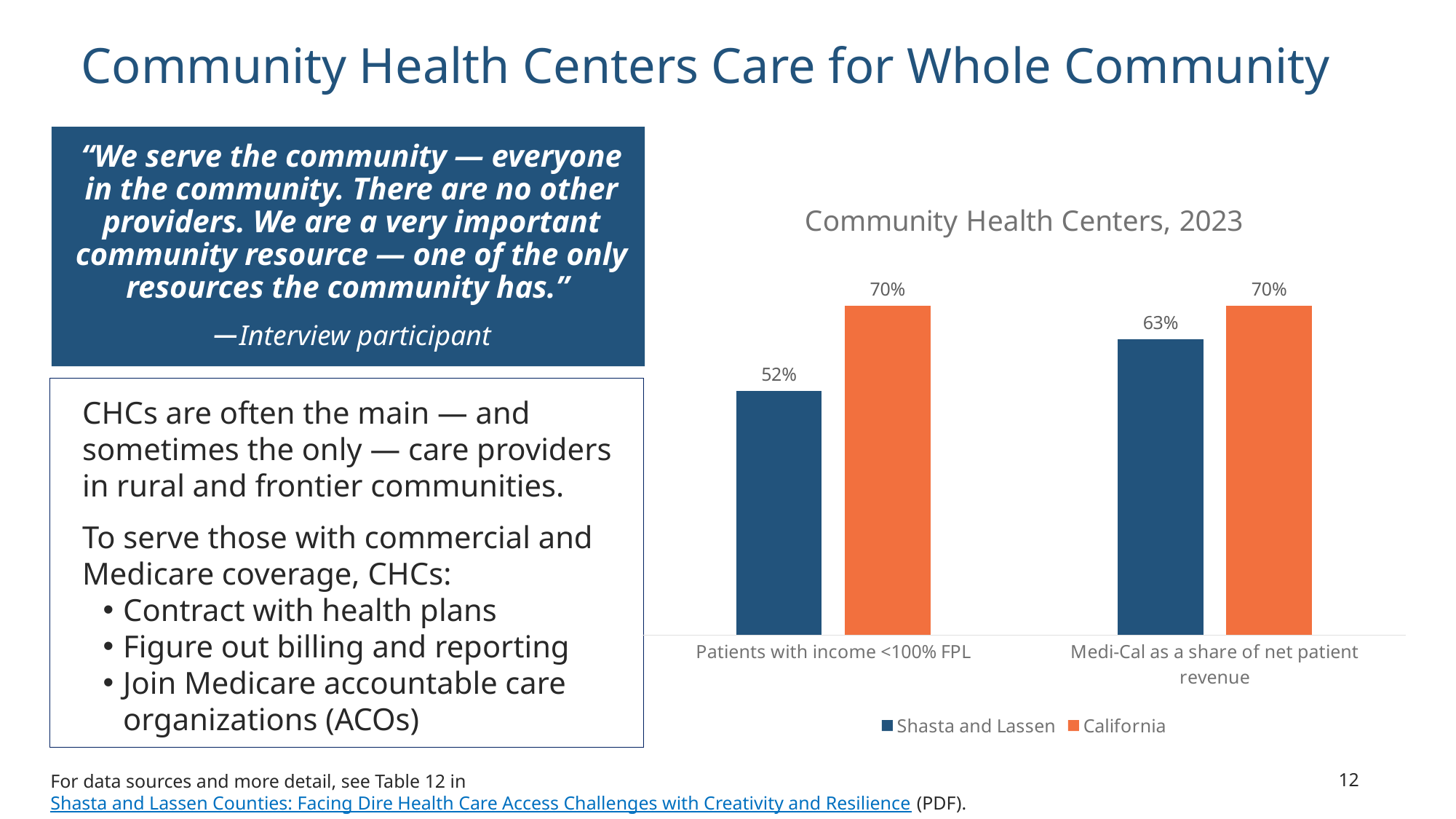
What is the value for Shasta and Lassen for Medi-Cal as a share of net patient revenue? 63% Which category has the lowest value for Shasta and Lassen? Patients with income <100% FPL What kind of chart is shown? Bar chart What is the value for Shasta and Lassen for Patients with income <100% FPL? 52% How many series does the legend list? 2 What is the value for California for Patients with income <100% FPL? 70% How many categories are shown on the x axis? 2 What is the value for California for Medi-Cal as a share of net patient revenue? 70% What is the title of the chart? Community Health Centers, 2023 What is the difference between California and Shasta and Lassen for Patients with income <100% FPL? 18% Which is larger for Medi-Cal as a share of net patient revenue: Shasta and Lassen or California? California What is the difference between California and Shasta and Lassen for Medi-Cal as a share of net patient revenue? 7%